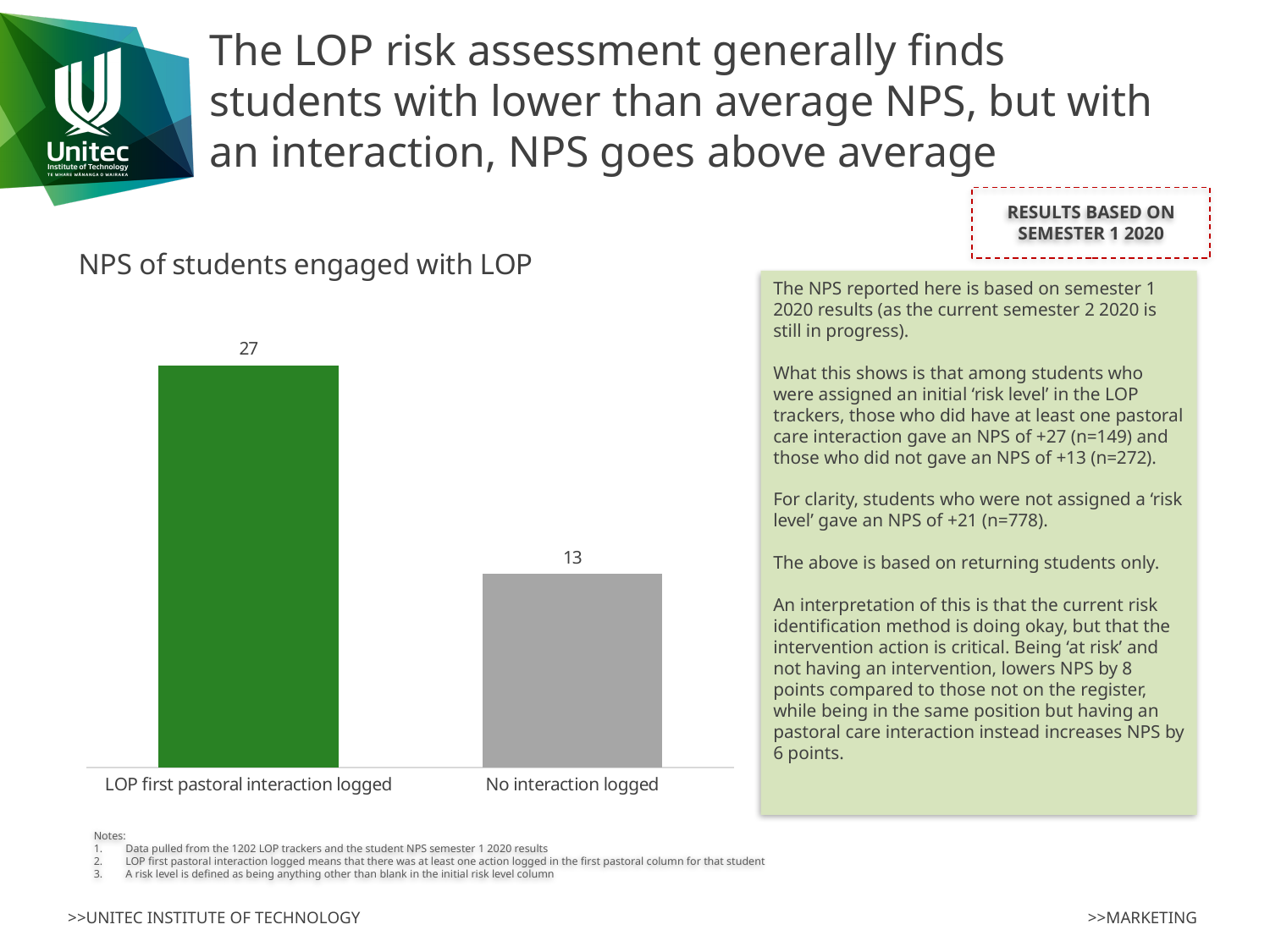
Which category has the lowest NPS in the chart? No interaction logged What is the difference in NPS between 'LOP first pastoral interaction logged' and 'No interaction logged'? 14 What is the NPS value for 'LOP first pastoral interaction logged'? 27 Which is larger: the NPS for 'LOP first pastoral interaction logged' or for 'No interaction logged'? LOP first pastoral interaction logged What kind of chart is shown on the slide? Bar chart What colour is the bar for 'LOP first pastoral interaction logged'? Green What is the NPS value for 'No interaction logged'? 13 What is the title of the chart? NPS of students engaged with LOP Which category has the highest NPS in the chart? LOP first pastoral interaction logged How many categories are shown in the chart? 2